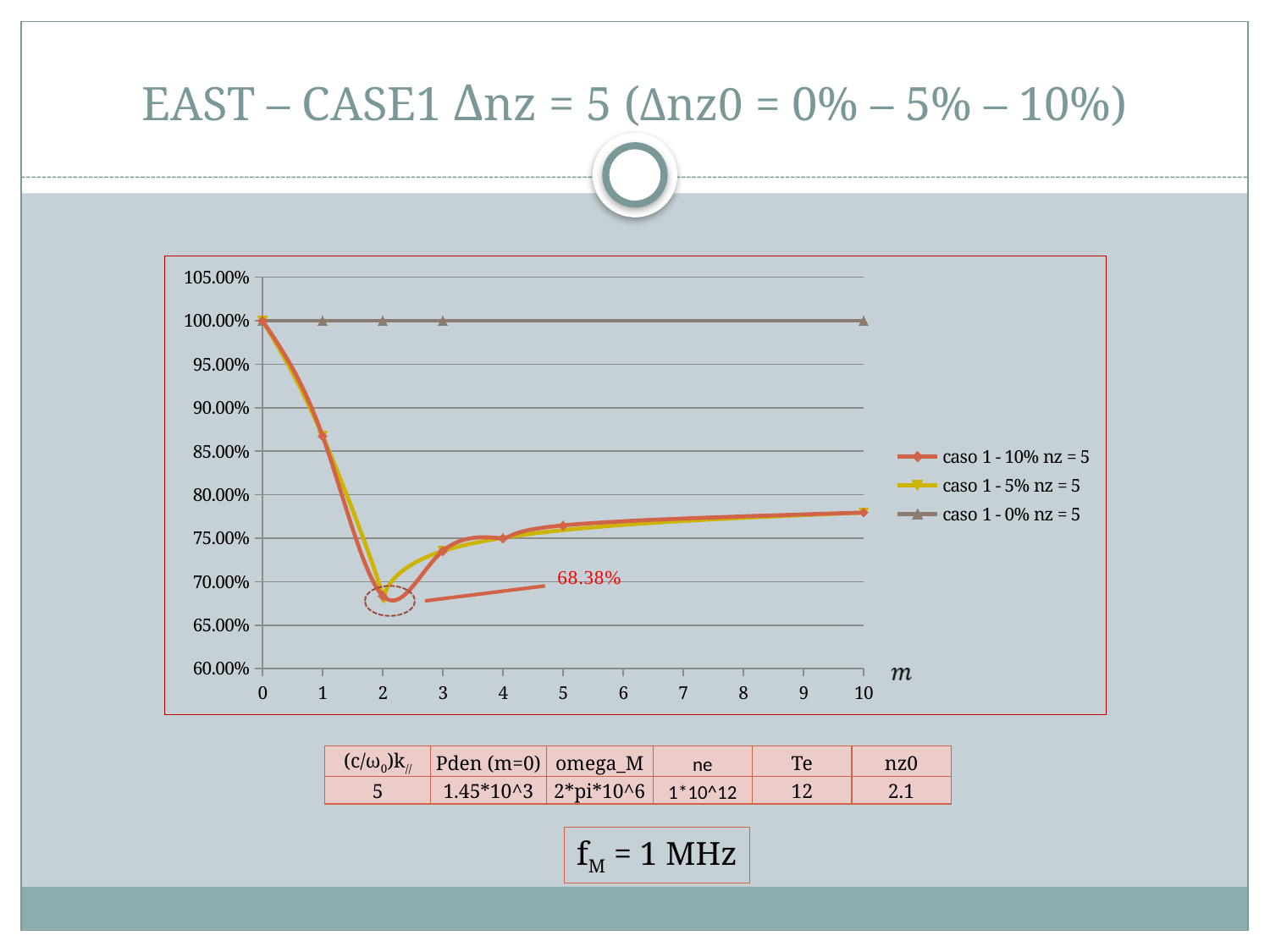
What is the lowest value shown on the y axis of the chart? 60.00% What is the value of the 'caso 1 - 0% nz = 5' series at m = 10? 100.00% Is the value of the 'caso 1 - 5% nz = 5' series at m = 3 greater or less than 75.00%? less Is the value of the 'caso 1 - 10% nz = 5' series at m = 1 greater or less than 80.00%? greater Is the value of the 'caso 1 - 10% nz = 5' series at m = 10 greater or less than 80.00%? less What type of chart is shown on the slide? line chart At which value of m does the 'caso 1 - 10% nz = 5' series reach its lowest point? 2 How many series does the chart legend list? 3 Does the 'caso 1 - 0% nz = 5' series rise, fall or stay constant as m increases? stays constant What is the label on the x axis of the chart? m Which series has the highest values across the whole range of m? caso 1 - 0% nz = 5 What is the minimum value annotated on the chart for the 'caso 1 - 10% nz = 5' series? 68.38%